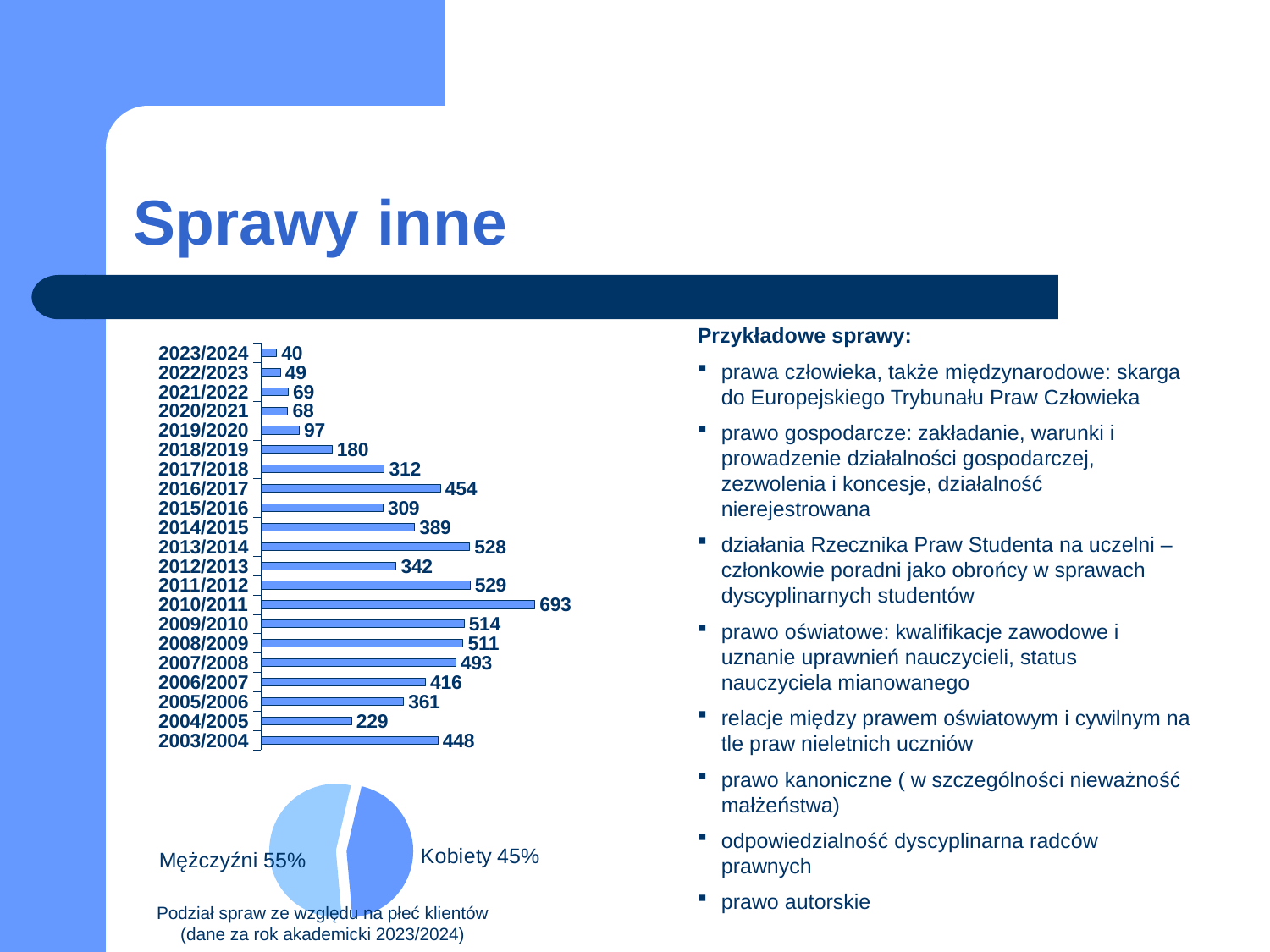
In the bar chart, which academic year has the highest value? 2010/2011 In the bar chart, what is the value for 2003/2004? 448 In the bar chart, what is the difference between the values for 2013/2014 and 2012/2013? 186 In the bar chart, what is the value for 2010/2011? 693 What type of chart is the upper chart on the slide? bar chart In the pie chart, what share is labelled Kobiety? 45% In the bar chart, which is larger: the value for 2016/2017 or the value for 2015/2016? 2016/2017 In the bar chart, which academic year has the lowest value? 2023/2024 In the pie chart, what share is labelled Mężczyźni? 55% In the bar chart, what is the value for 2023/2024? 40 How many academic years are shown in the bar chart? 21 How many slices does the pie chart have? 2